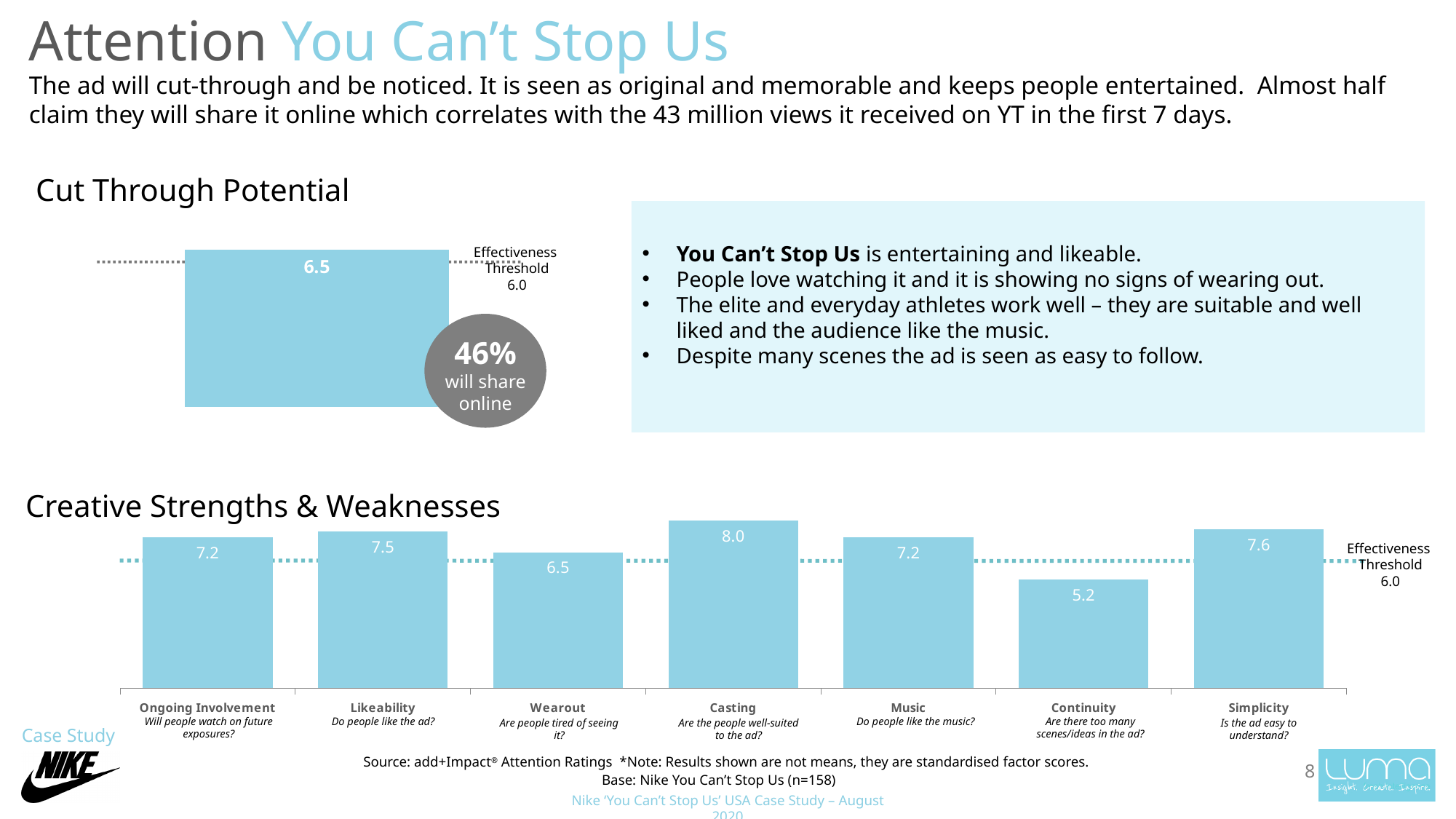
In the Creative Strengths & Weaknesses chart, how many categories are shown? 7 In the Creative Strengths & Weaknesses chart, which category has the lowest value? Continuity In the Creative Strengths & Weaknesses chart, what is the difference between the values for Casting and Continuity? 2.8 In the Creative Strengths & Weaknesses chart, which category has the highest value? Casting In the Creative Strengths & Weaknesses chart, which category falls below the Effectiveness Threshold of 6.0? Continuity In the Creative Strengths & Weaknesses chart, what is the value for Continuity? 5.2 What kind of chart is the Creative Strengths & Weaknesses chart? Bar chart In the Cut Through Potential chart, what is the value of the bar? 6.5 In the Creative Strengths & Weaknesses chart, what is the Effectiveness Threshold value shown by the dotted line? 6.0 In the Creative Strengths & Weaknesses chart, what is the value for Casting? 8.0 In the Creative Strengths & Weaknesses chart, which is larger, Likeability or Simplicity? Simplicity In the Creative Strengths & Weaknesses chart, what is the value for Wearout? 6.5